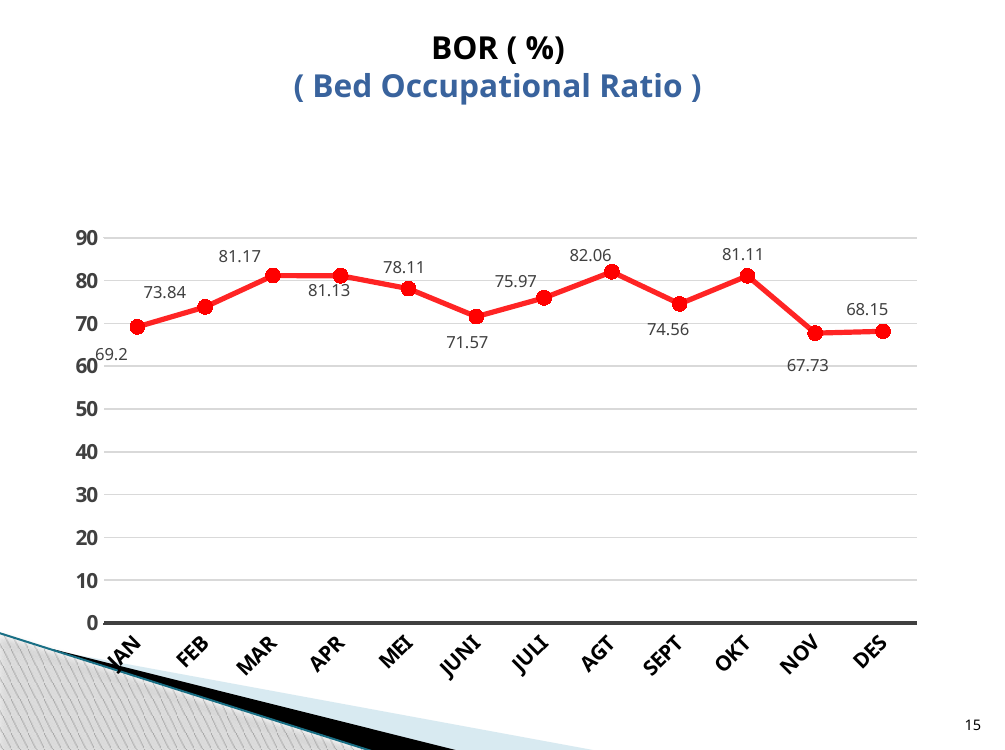
What is the title of the chart? BOR ( %) ( Bed Occupational Ratio ) What kind of chart is shown on the slide? line chart What is the BOR value for JUNI? 71.57 What is the BOR value for MAR? 81.17 Which month has the lowest BOR value? NOV How many months are plotted on the chart? 12 Is the BOR value for DES greater or less than 70? less Which month has a larger BOR value, FEB or JULI? JULI What is the difference between the BOR values for AGT and SEPT? 7.5 Which month has the highest BOR value? AGT What is the BOR value for NOV? 67.73 Does the BOR value rise or fall from OKT to NOV? fall